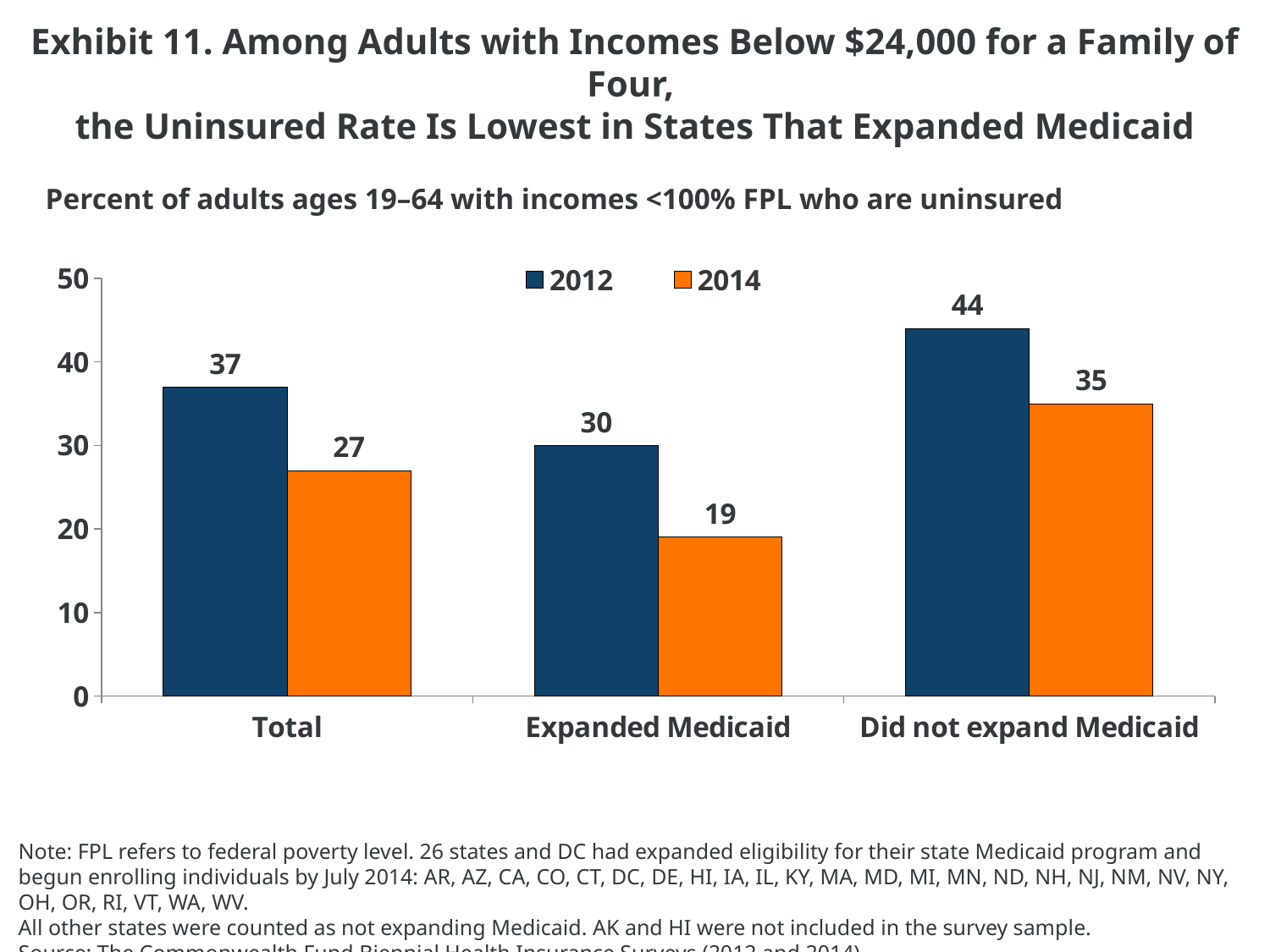
Which category has the highest 2014 value? Did not expand Medicaid Which colour represents the 2014 series in the legend? Orange What is the difference between the 2012 values for Did not expand Medicaid and Expanded Medicaid? 14 What is the 2012 value for Did not expand Medicaid? 44 What is the 2012 value for Total? 37 What is the difference between the 2012 and 2014 values for Expanded Medicaid? 11 What is the 2014 value for Expanded Medicaid? 19 Which is larger: the 2014 value for Total or the 2014 value for Did not expand Medicaid? Did not expand Medicaid Which category has the lowest 2012 value? Expanded Medicaid What kind of chart is shown on the slide? Bar chart How many series does the legend list? 2 How many categories are shown on the x axis? 3